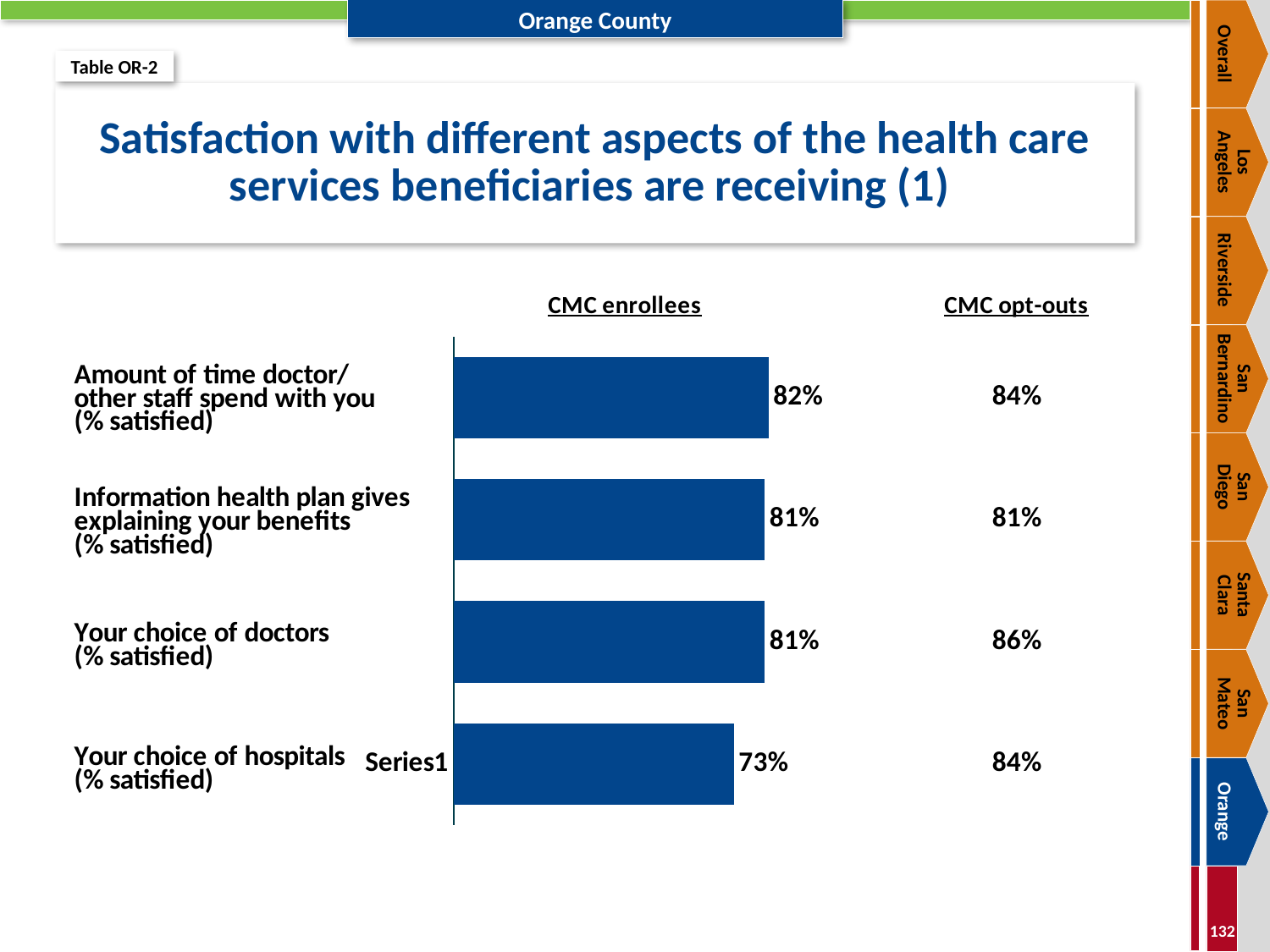
What is the CMC enrollees value for 'Your choice of doctors (% satisfied)'? 81% What kind of chart is shown on the slide? bar chart Which category has the highest CMC enrollees value in the chart? Amount of time doctor/other staff spend with you (% satisfied) What is the difference between the CMC enrollees values for 'Amount of time doctor/other staff spend with you' and 'Your choice of hospitals'? 9% Which category has the lowest CMC enrollees value in the chart? Your choice of hospitals (% satisfied) How many bars are plotted in the chart? 4 What series name is printed next to the bottom bar of the chart? Series1 What is the CMC opt-outs value printed for 'Your choice of doctors (% satisfied)'? 86% What is the CMC enrollees value for 'Amount of time doctor/other staff spend with you (% satisfied)'? 82% Which is larger for 'Your choice of doctors (% satisfied)': the CMC enrollees value or the CMC opt-outs value? CMC opt-outs What is the CMC enrollees value for 'Information health plan gives explaining your benefits (% satisfied)'? 81% What is the CMC enrollees value for 'Your choice of hospitals (% satisfied)'? 73%